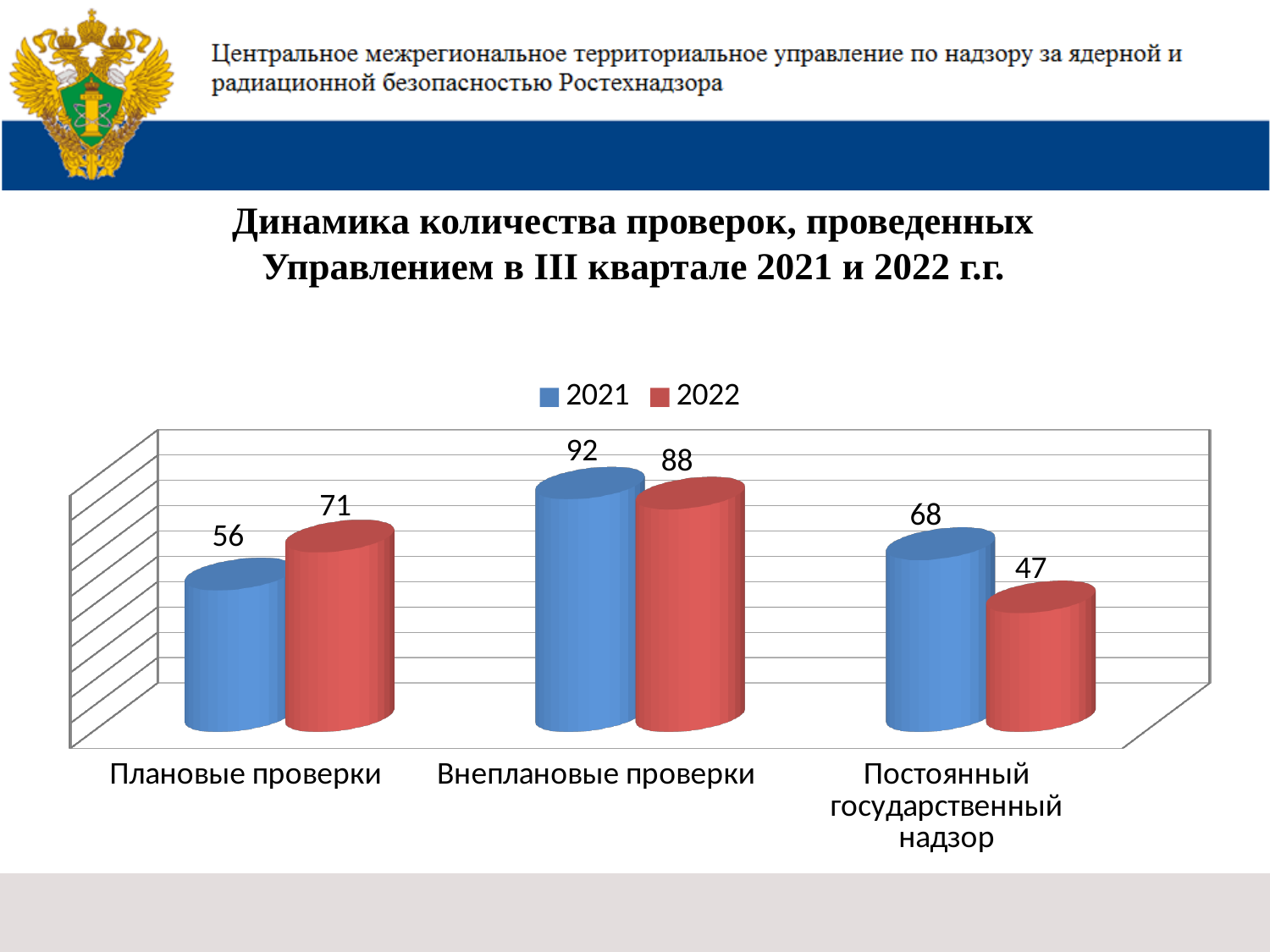
What is the value for Плановые проверки in 2021? 56 What kind of chart is shown on the slide? Bar chart Which category has the lowest value for 2022? Постоянный государственный надзор What is the value for Постоянный государственный надзор in 2022? 47 Which category has the highest value for 2021? Внеплановые проверки Which colour represents the 2022 series in the legend? Red What is the difference between the 2021 and 2022 values for Плановые проверки? 15 What is the value for Внеплановые проверки in 2022? 88 Which is larger for Внеплановые проверки: the 2021 value or the 2022 value? 2021 What is the difference between the 2021 and 2022 values for Постоянный государственный надзор? 21 How many categories are shown on the x axis? 3 How many series does the legend list? 2